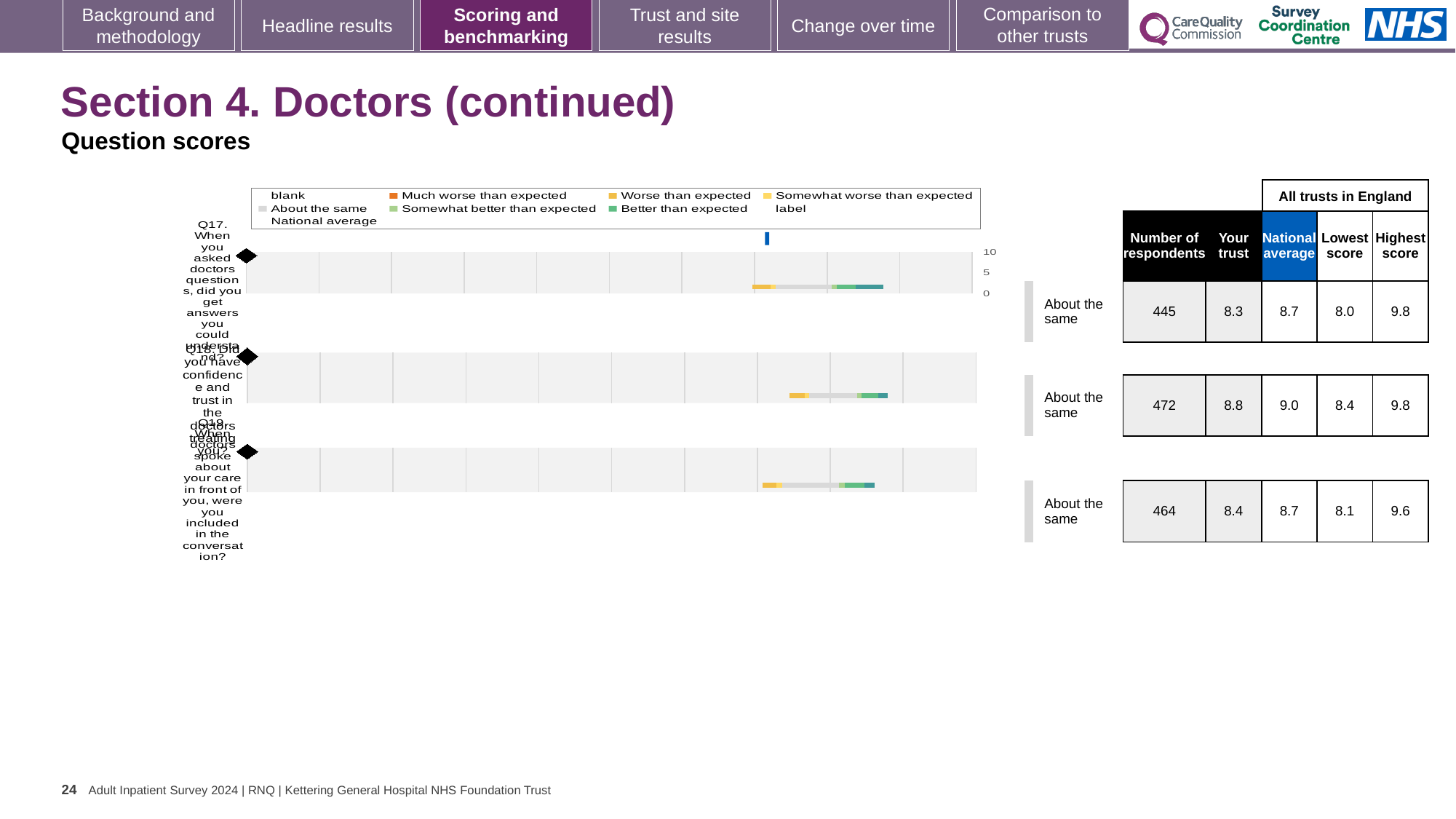
Which question has the highest 'Your trust' score? Q18 What is the 'Your trust' score for Q17? 8.3 What benchmark category is shown for Q17? About the same What is the difference between the national average and the 'Your trust' score for Q18? 0.2 How many respondents answered Q19? 464 How many entries does the chart legend list? 9 What is the highest score among all trusts in England for Q19? 9.6 How many questions (categories) are plotted in the chart? 3 What is the national average score for Q18? 9.0 For Q17, which is larger: the 'Your trust' score or the national average? National average What kind of chart is shown on the slide? bar chart Which question has the lowest 'Your trust' score? Q17